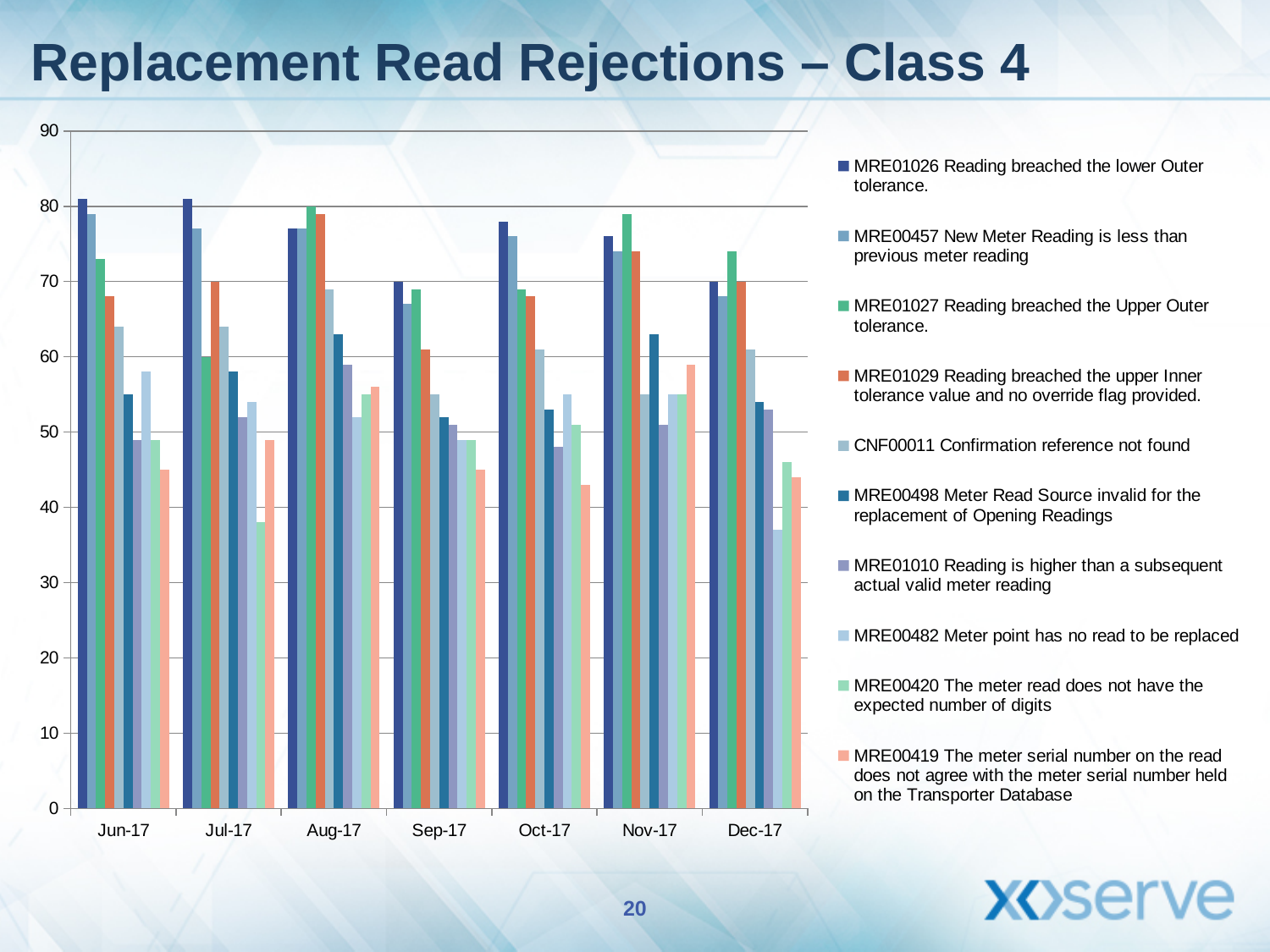
Is the value for MRE00482 in Jul-17 greater or less than 40? greater In Jun-17, which is larger: the value for MRE01026 or the value for MRE00419? MRE01026 Is the value for MRE00457 in Jun-17 greater or less than 70? greater How many months are shown along the x axis of the chart? 7 Is the value for MRE00419 in Nov-17 greater or less than 50? greater What kind of chart is shown on the slide? bar chart In Jul-17, which series has the lowest value? MRE00420 What is the title of the slide containing the chart? Replacement Read Rejections – Class 4 In Dec-17, which series has the lowest value? MRE00482 How many series does the chart's legend list? 10